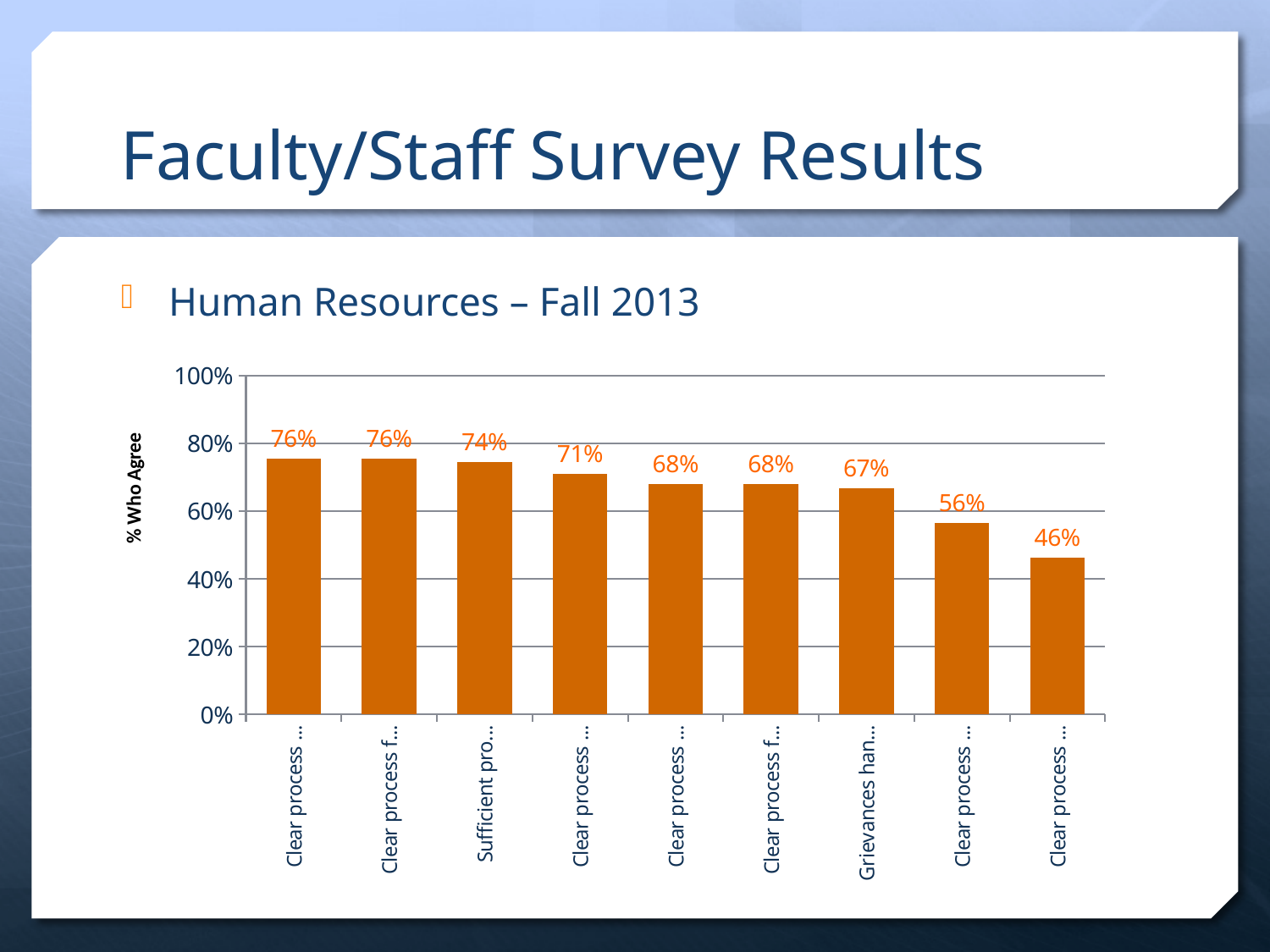
What is the difference between the first bar (76%) and the last bar (46%)? 30% Do the bar values rise or fall from left to right across the chart? fall How many bars are plotted in the chart? 9 What is the lowest value shown in the chart? 46% What type of chart is shown on the slide? bar chart What is the value of the bar labelled 'Sufficient pro...'? 74% What is the value of the last (rightmost) bar in the chart? 46% What is the highest value shown in the chart? 76% What is the value of the bar labelled 'Grievances han...'? 67% What is the value of the eighth bar from the left? 56% What is the value of the first (leftmost) bar in the chart? 76% What is the label of the vertical axis? % Who Agree